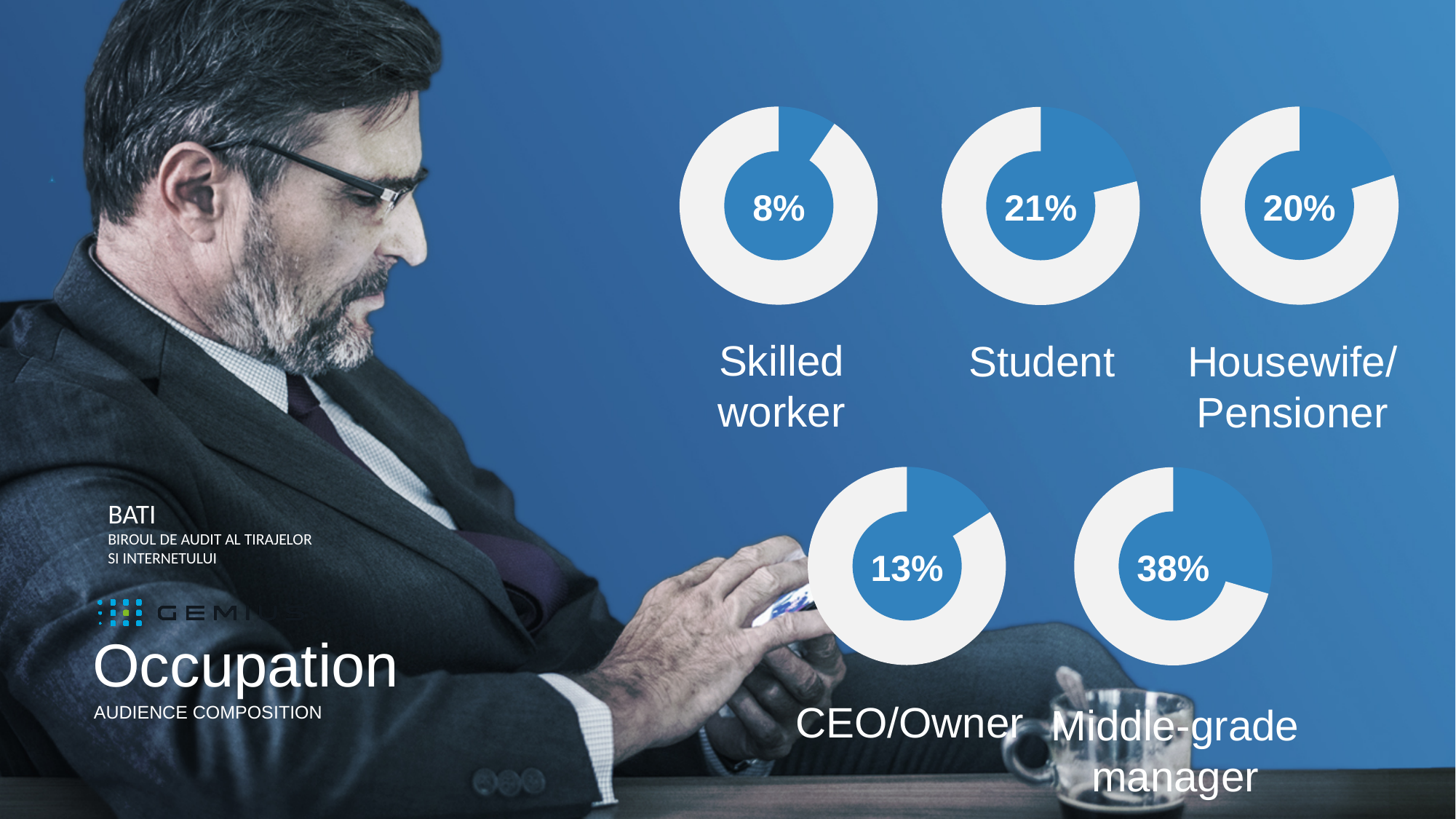
What percentage is shown in the Skilled worker donut chart? 8% What is the title of the slide containing the occupation charts? Occupation What percentage is shown in the CEO/Owner donut chart? 13% What percentage is shown in the Student donut chart? 21% What is the difference between the Middle-grade manager percentage and the CEO/Owner percentage? 25% Across the five donut charts, which occupation has the lowest percentage? Skilled worker Which is larger, the Student percentage or the Housewife/Pensioner percentage? Student What percentage is shown in the Housewife/Pensioner donut chart? 20% Across the five donut charts, which occupation has the highest percentage? Middle-grade manager What percentage is shown in the Middle-grade manager donut chart? 38% How many donut charts are shown on the slide? 5 What kind of chart is used to show each occupation's percentage? Donut chart